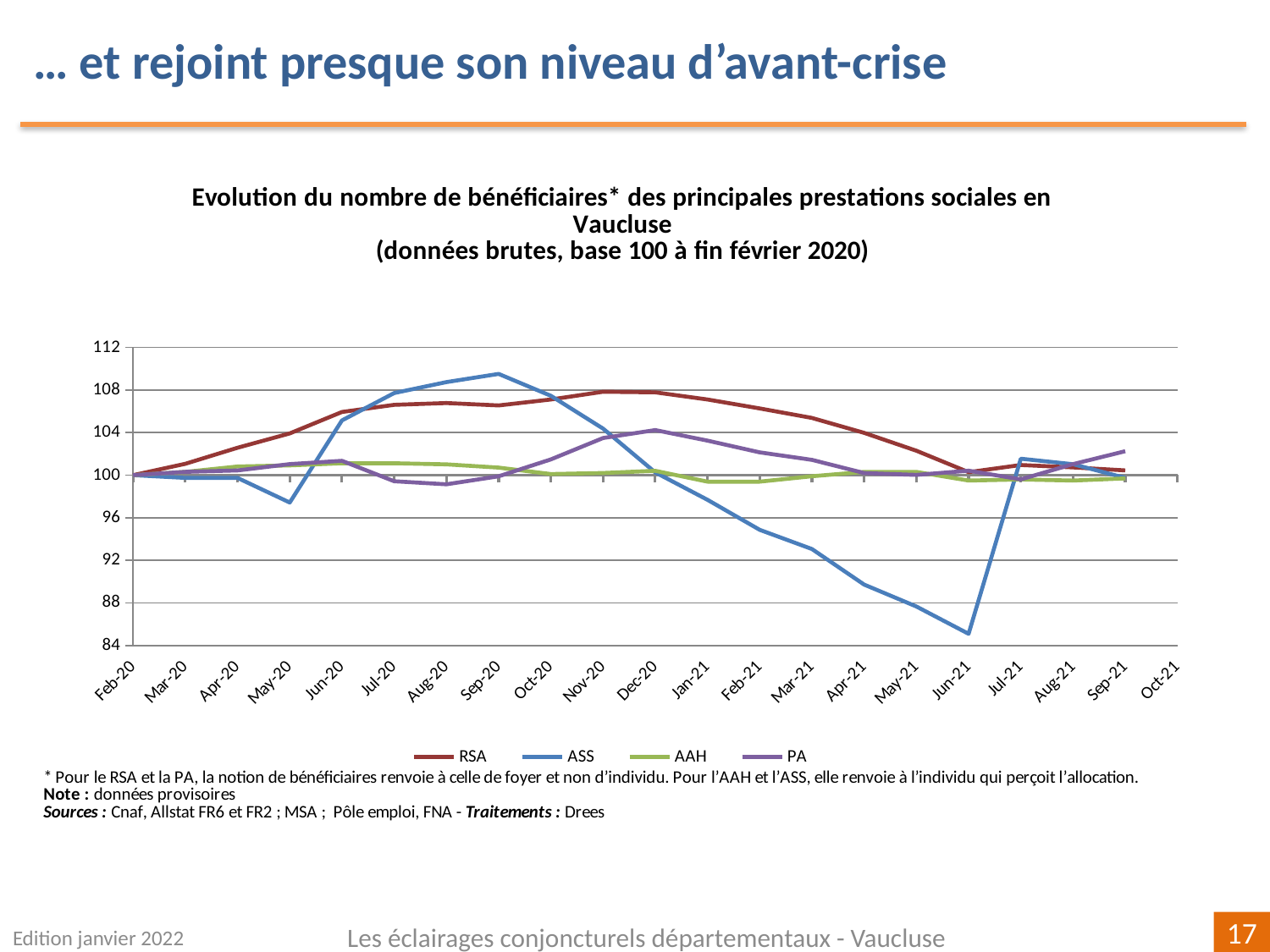
Which series has the highest value in Sep-20? ASS Which series has the highest value in Nov-20? RSA Does the ASS series rise or fall between Sep-20 and Jun-21? fall Which series has the lowest value in Jun-21? ASS What is the value of all four series in Feb-20, the base month? 100 Is the value for ASS in Sep-20 greater or less than 108? greater How many series does the legend list? 4 Is the value for RSA in Nov-20 greater or less than 104? greater Is the value for ASS in Apr-21 greater or less than 92? less Which is larger in Jun-21, the value for RSA or the value for ASS? RSA What kind of chart is shown on the slide? line chart